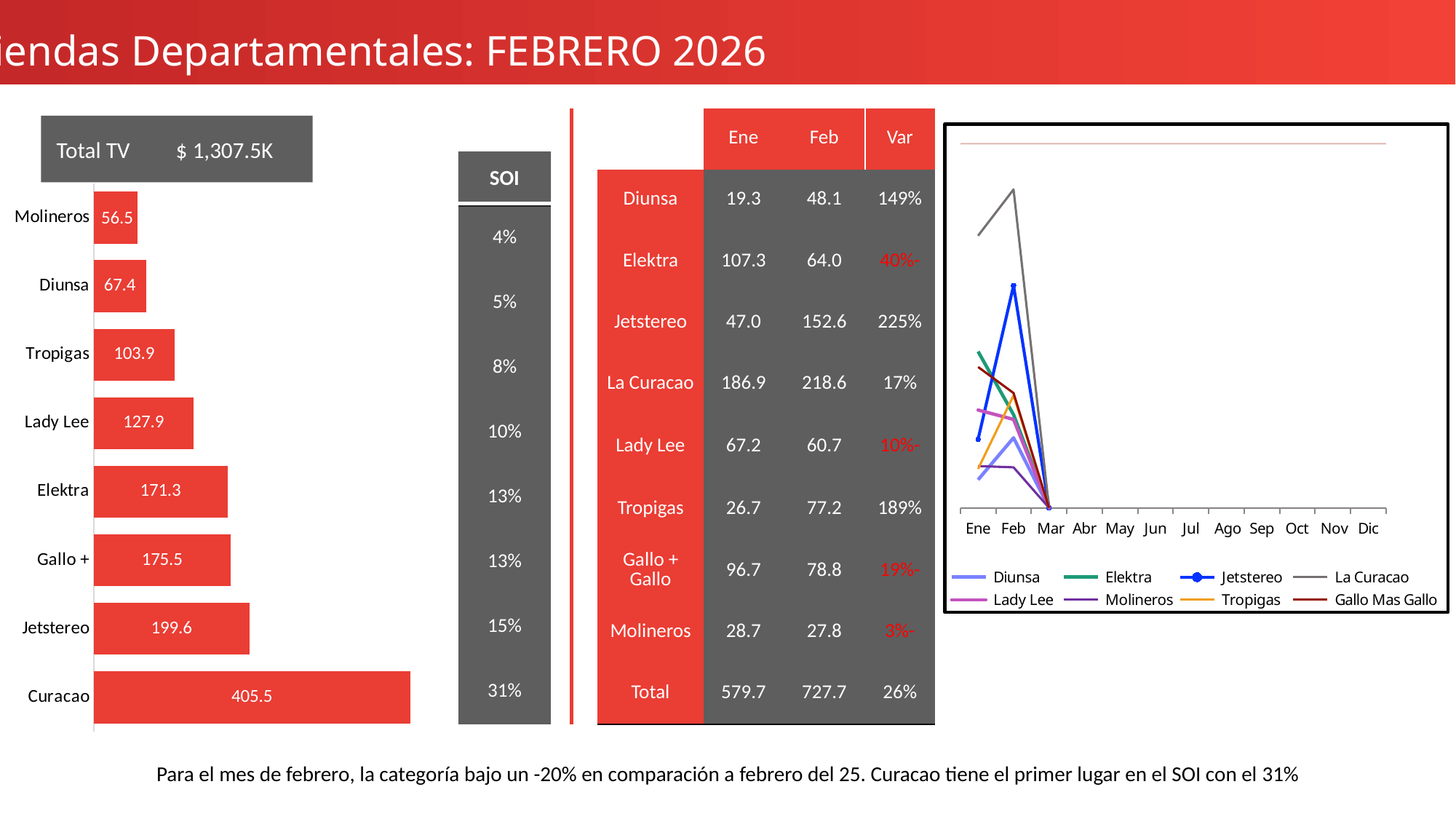
In the line chart on the right, does the Jetstereo line rise or fall from Ene to Feb? Rise In the bar chart on the left, what is the value for Jetstereo? 199.6 In the bar chart on the left, which is larger, the value for Elektra or the value for Gallo +? Gallo + In the bar chart on the left, what is the difference between the values for Curacao and Jetstereo? 205.9 In the bar chart on the left, which category has the highest value? Curacao What kind of chart is the chart on the left of the slide? Bar chart How many series does the legend of the line chart on the right list? 8 How many categories are shown in the bar chart on the left? 8 In the bar chart on the left, which category has the lowest value? Molineros In the bar chart on the left, what is the value for Lady Lee? 127.9 In the line chart on the right, which series has the highest value in Feb? La Curacao How many months are labelled on the x axis of the line chart on the right? 12